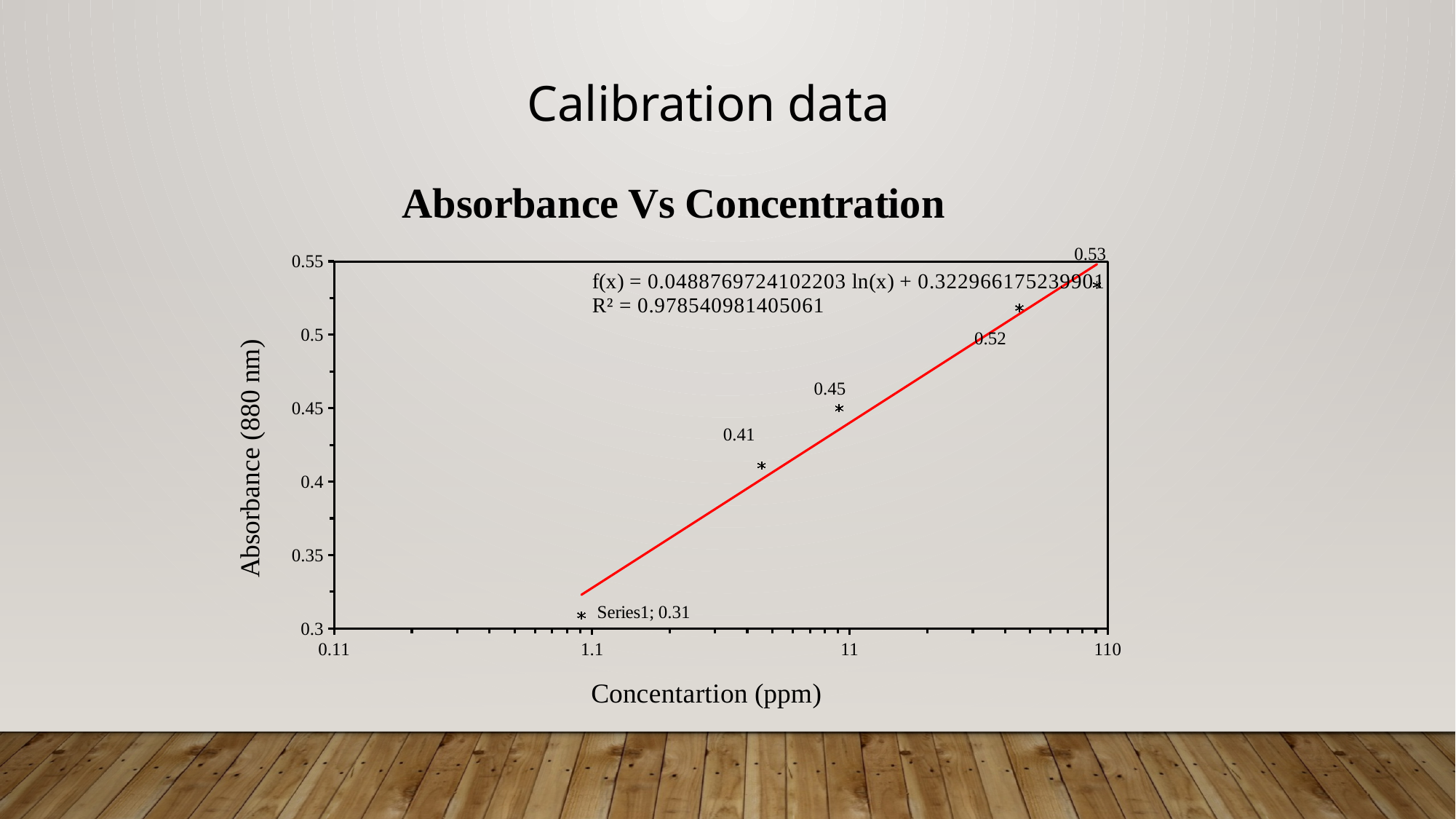
What kind of chart is shown on the slide? Scatter chart What is the lowest absorbance value labelled on the chart? 0.31 Is the absorbance of the lowest data point greater or less than 0.35? less What is the title of the chart? Absorbance Vs Concentration What is the highest absorbance value labelled on the chart? 0.53 Do the absorbance values rise or fall as concentration increases along the x axis? Rise Is the absorbance of the highest data point greater or less than 0.5? greater What is the R² value shown for the trendline? 0.978540981405061 How many data points are plotted in the chart? 5 What is the difference between the labelled values 0.45 and 0.41? 0.04 What is the difference between the highest and lowest labelled absorbance values? 0.22 What is the name of the series shown in the data label of the lowest point? Series1